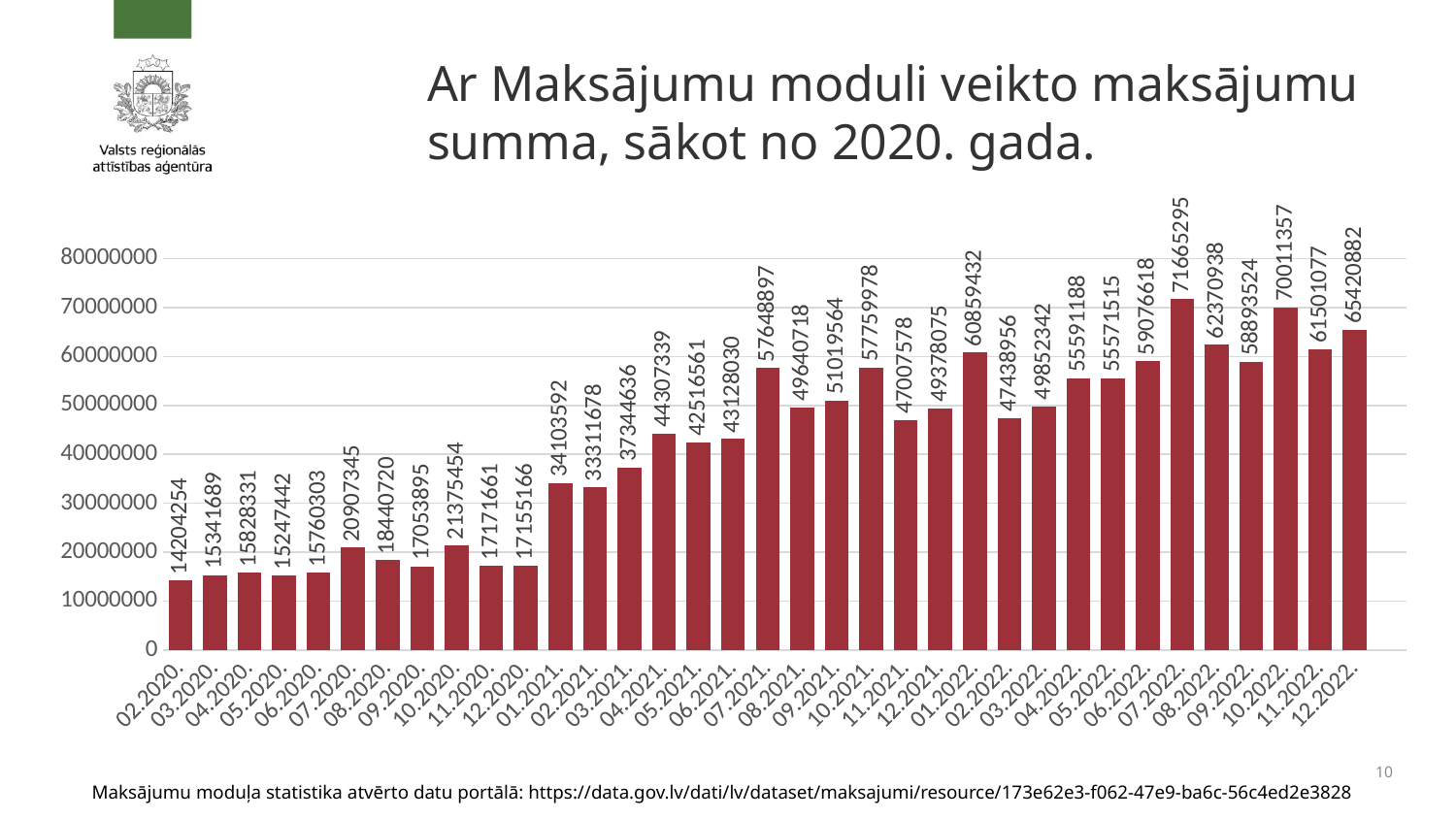
Which month has the lowest value? 02.2020. What is the value for 07.2022.? 71665295 Is the value for 07.2021. greater or less than 50000000? greater How many months (bars) are shown in the chart? 35 What is the value for 01.2021.? 34103592 What is the difference between the values for 12.2022. and 11.2022.? 3919805 What kind of chart is shown on the slide? bar chart What is the value for 02.2020.? 14204254 Which month has the highest value? 07.2022. Do the values generally rise or fall from 02.2020. to 12.2022.? rise Which is larger, the value for 10.2022. or the value for 08.2022.? 10.2022. What is the value for 12.2022.? 65420882